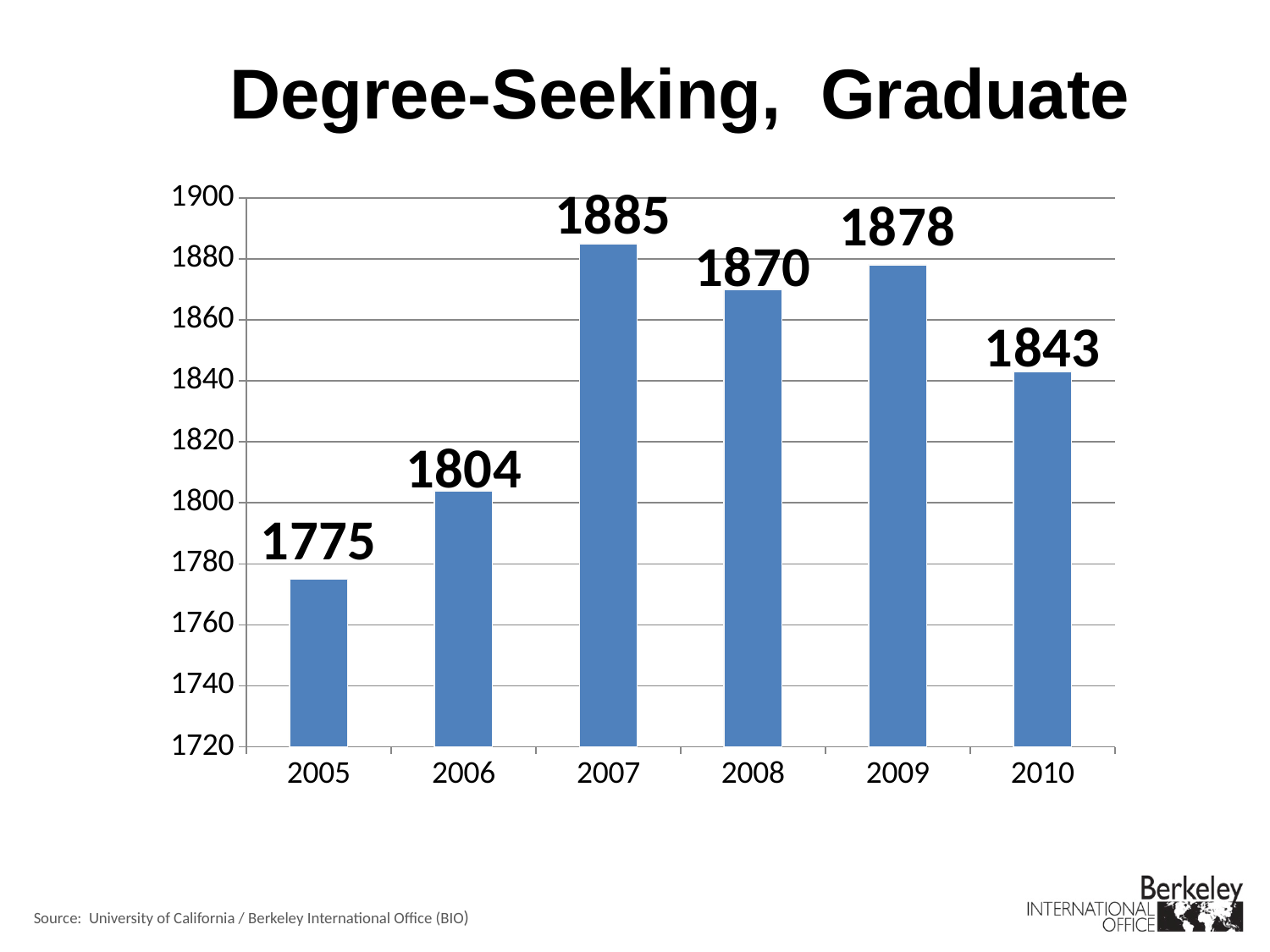
What is the title of the chart? Degree-Seeking, Graduate What is the difference between the values for 2007 and 2005? 110 What is the value for 2005? 1775 How many years are shown on the chart? 6 Is the value for 2006 greater or less than 1820? less What kind of chart is shown on the slide? bar chart Which is larger, the value for 2006 or the value for 2010? 2010 Which year has the lowest value? 2005 Which year has the highest value? 2007 What is the value for 2010? 1843 What is the value for 2008? 1870 What is the difference between the values for 2009 and 2010? 35